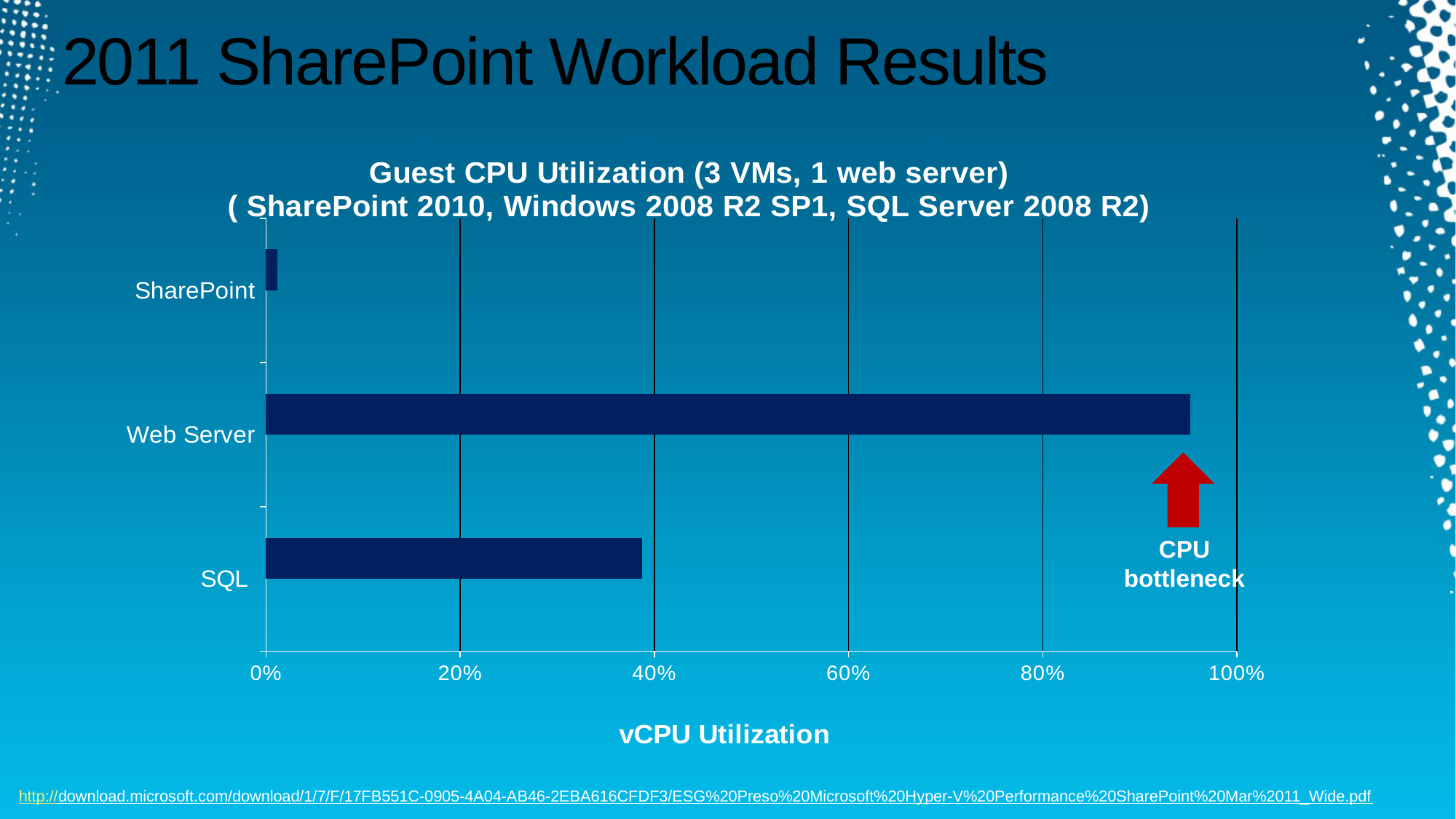
Which category has the highest vCPU utilization? Web Server Which has a higher vCPU utilization, SharePoint or SQL? SQL How many categories are plotted in the chart? 3 Is the vCPU utilization for SharePoint greater or less than 20%? less Which has a higher vCPU utilization, SQL or Web Server? Web Server Is the vCPU utilization for Web Server greater or less than 80%? greater What is the label of the horizontal axis of the chart? vCPU Utilization What kind of chart is shown on the slide? bar chart Is the vCPU utilization for SQL greater or less than 40%? less Which category has the lowest vCPU utilization? SharePoint Which category is marked with the red arrow labelled "CPU bottleneck"? Web Server